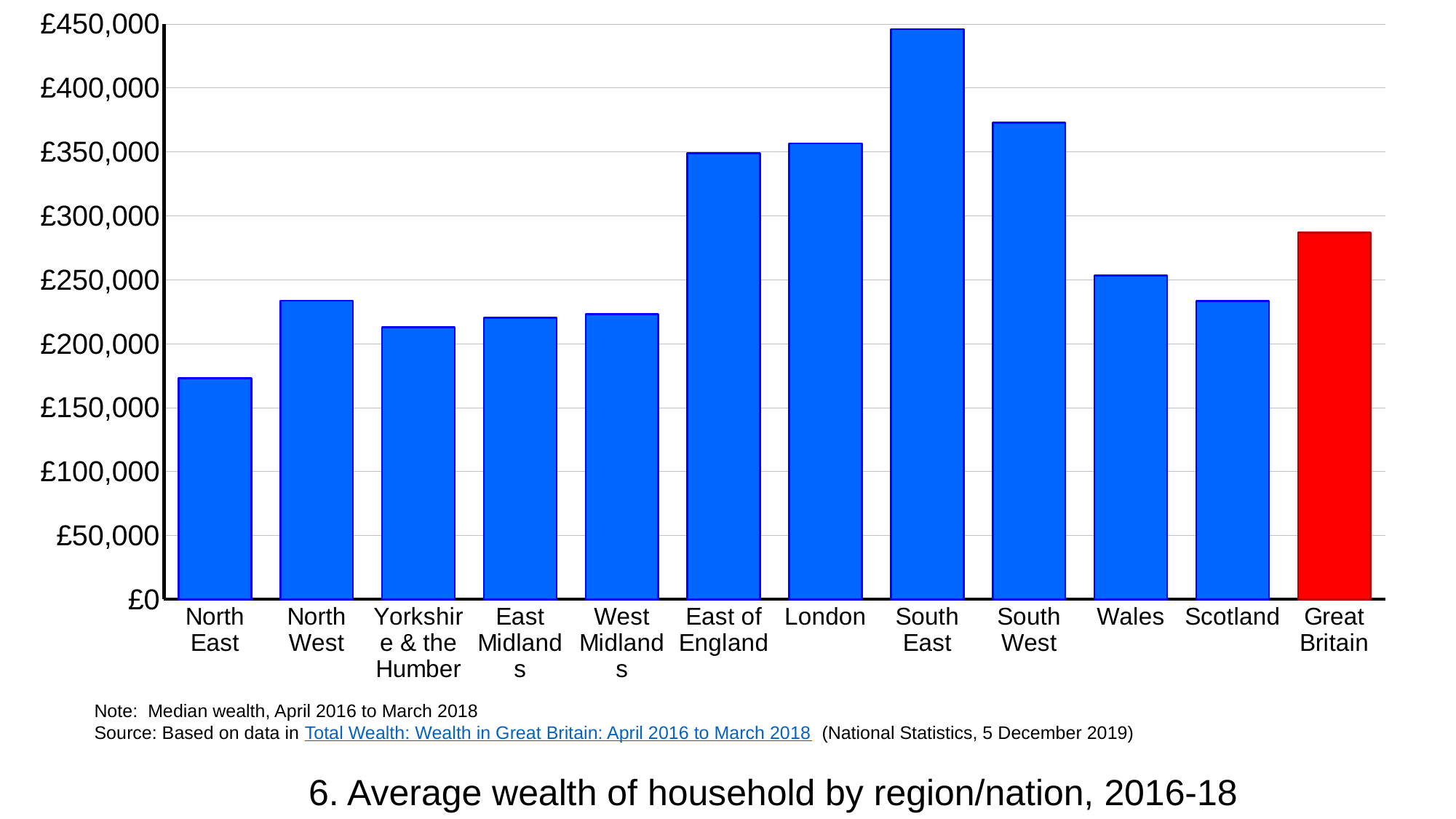
Which has the larger value, Wales or Scotland? Wales Is the value for South East greater or less than £400,000? greater Which bar is coloured red rather than blue? Great Britain Which region or nation has the lowest average household wealth? North East Which has the larger value, London or South East? South East Which region or nation has the highest average household wealth? South East Is the value for South West greater or less than £350,000? greater What kind of chart is shown on the slide? Bar chart Is the value for North East greater or less than £200,000? less How many bars (regions/nations) are plotted on the chart? 12